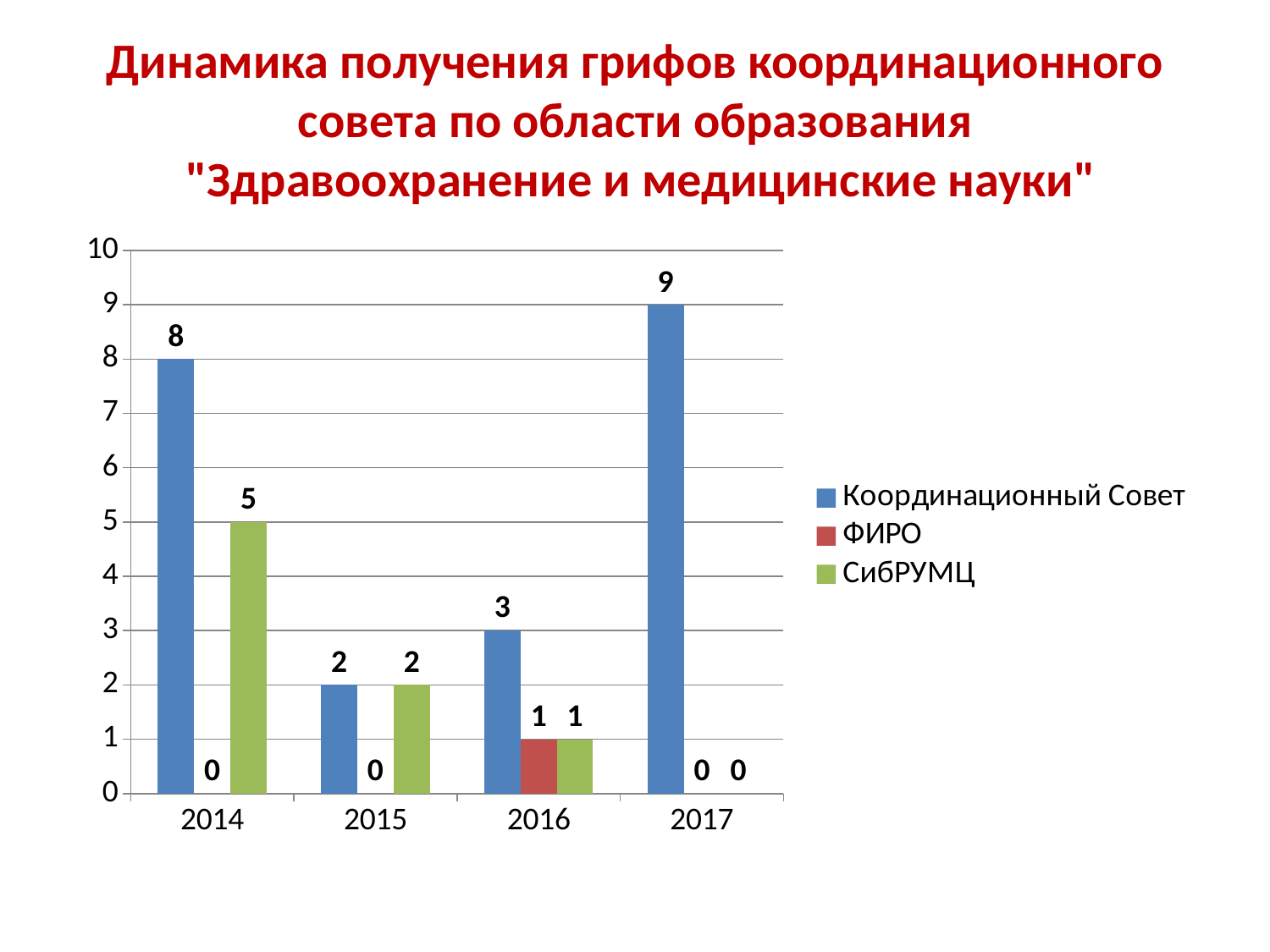
What type of chart is shown on the slide? bar chart What is the value for ФИРО in 2016? 1 How many series does the legend list? 3 Which series is shown in green in the legend? СибРУМЦ In which year is the value for Координационный Совет highest? 2017 What is the value for СибРУМЦ in 2014? 5 What is the value for Координационный Совет in 2017? 9 What is the difference between the Координационный Совет values for 2017 and 2016? 6 In which year is the value for Координационный Совет lowest? 2015 Which is larger in 2014: the value for Координационный Совет or the value for СибРУМЦ? Координационный Совет What is the value for Координационный Совет in 2014? 8 How many years are shown on the x axis? 4